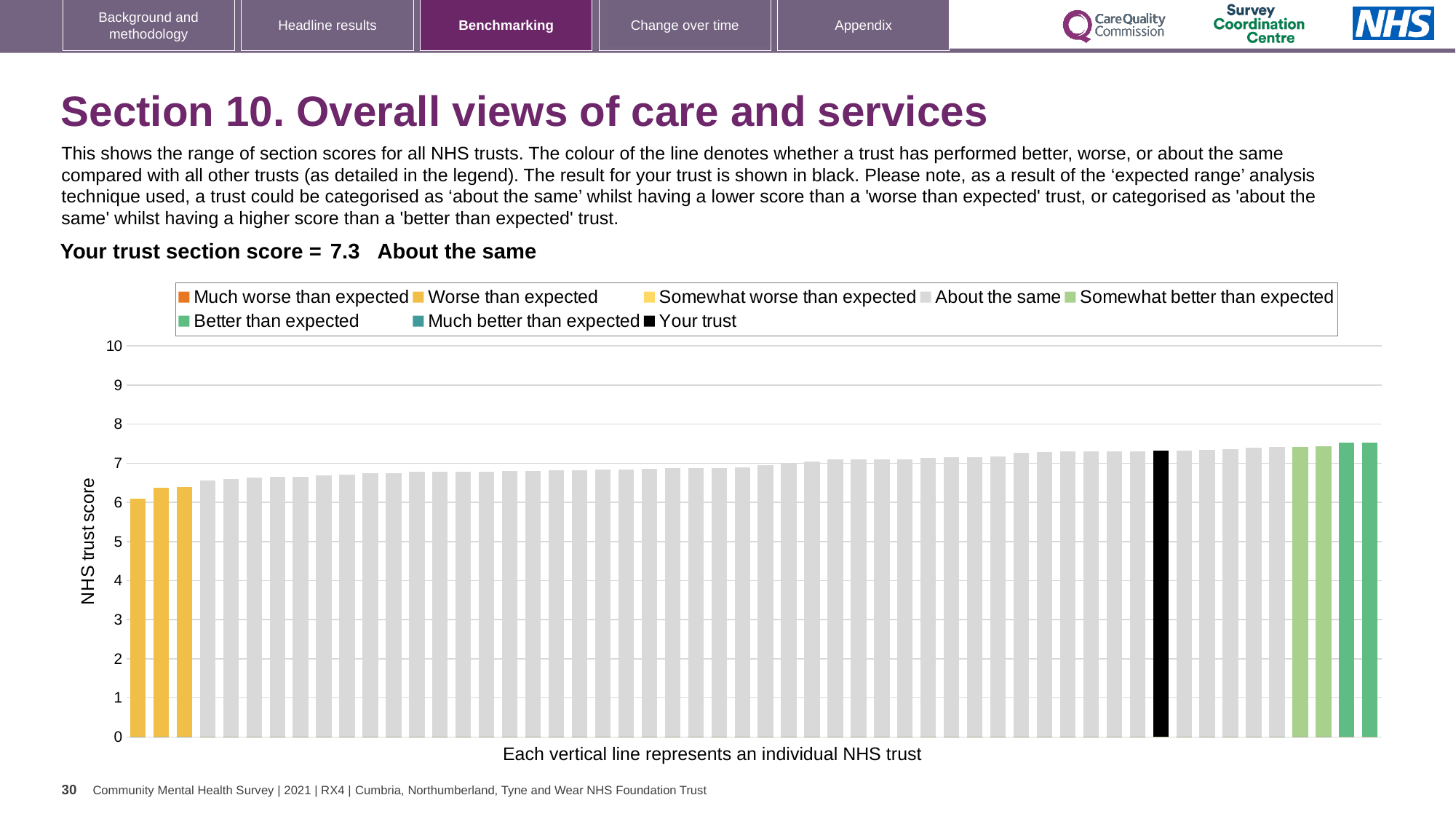
What category does the slide assign to your trust's section score? About the same How many bars are coloured as 'Worse than expected' (yellow) in the chart? 3 Do the bar values rise or fall from left to right along the x axis? rise What is the label on the y axis of the chart? NHS trust score Is the value of the lowest bar in the chart greater or less than 7? less Is the value for your trust (the black bar) greater or less than 7? greater Is the value of the highest bar in the chart greater or less than 8? less How many entries does the chart legend list? 8 Is your trust's score higher or lower than the highest bar in the chart? lower What is the section score for your trust shown on the slide? 7.3 What colour is the bar representing your trust? Black What kind of chart is shown on the slide? Bar chart